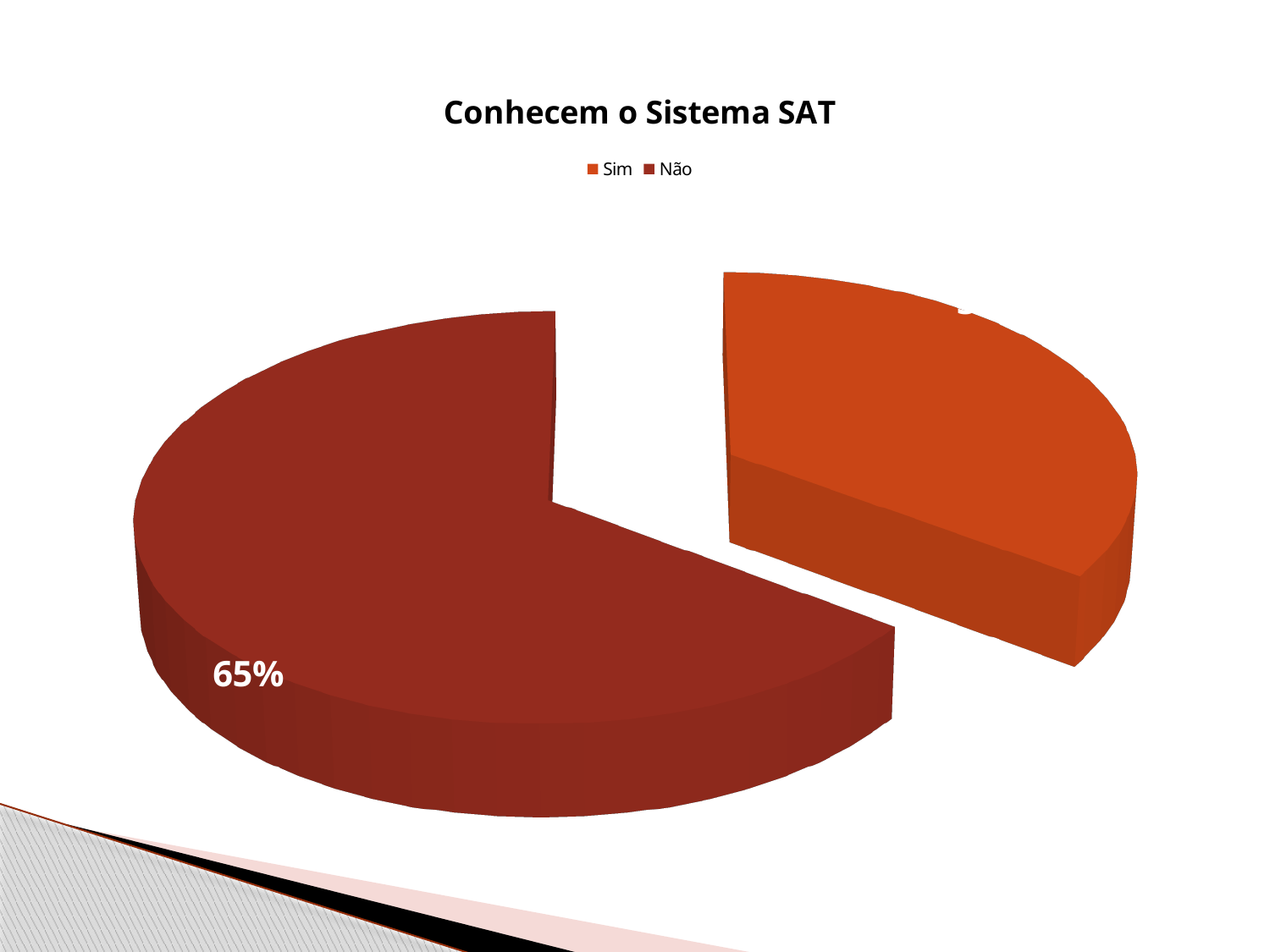
What percentage is shown for the Não slice? 65% Does the Não slice represent more or less than half of the pie? more Which slice is the largest in the pie chart? Não What type of chart is shown on the slide? pie chart What colour is the Sim slice in the pie chart? orange What is the title of the chart? Conhecem o Sistema SAT How many slices does the pie chart have? 2 Which is larger, the Sim slice or the Não slice? Não Which slice is the smallest in the pie chart? Sim How many entries does the legend list? 2